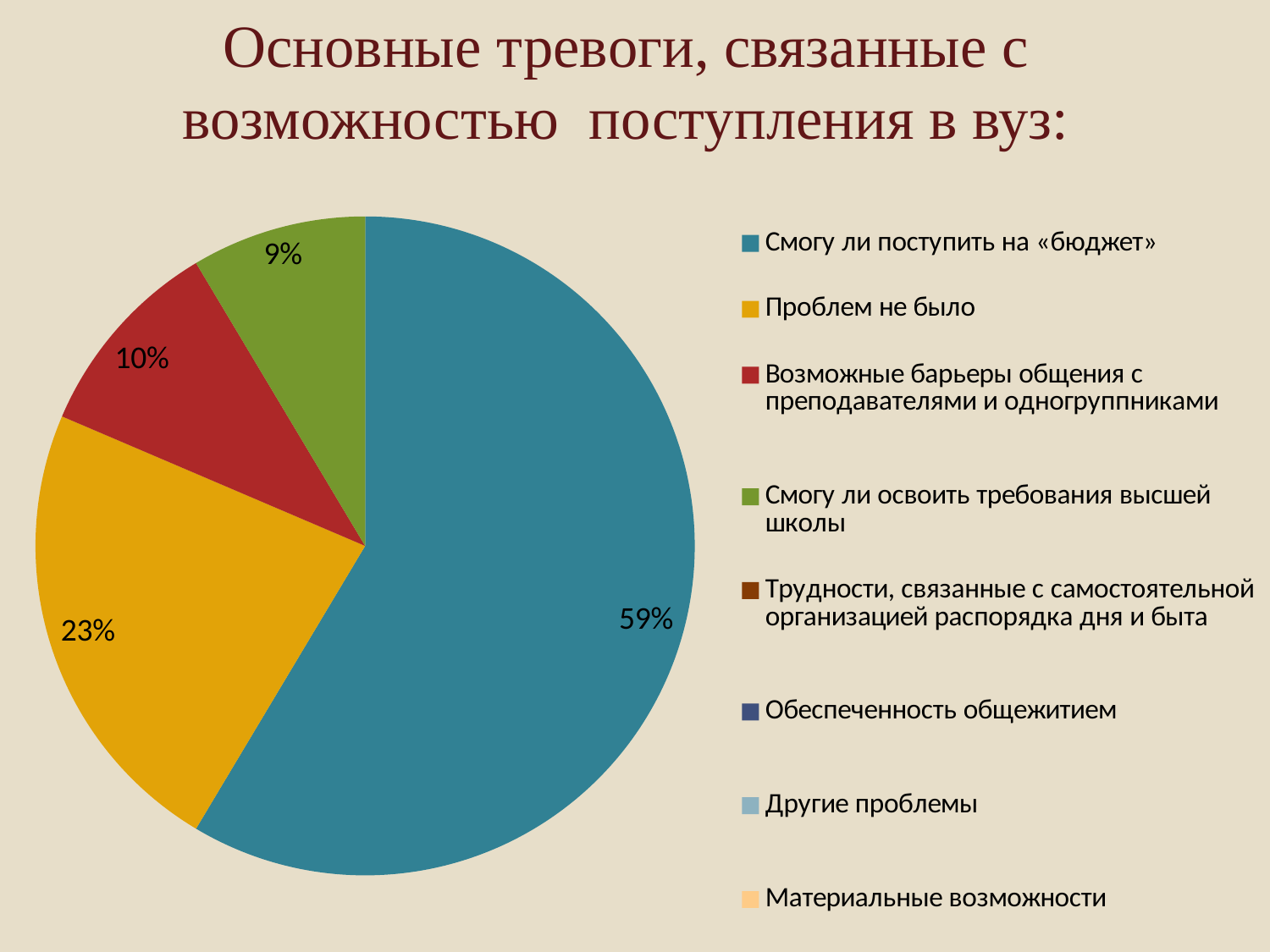
Which of the labelled slices is the smallest? Смогу ли освоить требования высшей школы What share of the pie does «Проблем не было» take? 23% What kind of chart is shown on the slide? pie chart Which is larger: the slice for «Проблем не было» or the slice for «Возможные барьеры общения с преподавателями и одногруппниками»? Проблем не было What share of the pie does «Смогу ли поступить на «бюджет»» take? 59% What is the difference in percentage points between «Смогу ли поступить на «бюджет»» and «Проблем не было»? 36 What share of the pie does «Возможные барьеры общения с преподавателями и одногруппниками» take? 10% How many entries does the legend list? 8 What colour is the slice for «Проблем не было»? yellow Which category has the largest slice of the pie? Смогу ли поступить на «бюджет» How many slices of the pie have a percentage label? 4 What share of the pie does «Смогу ли освоить требования высшей школы» take? 9%